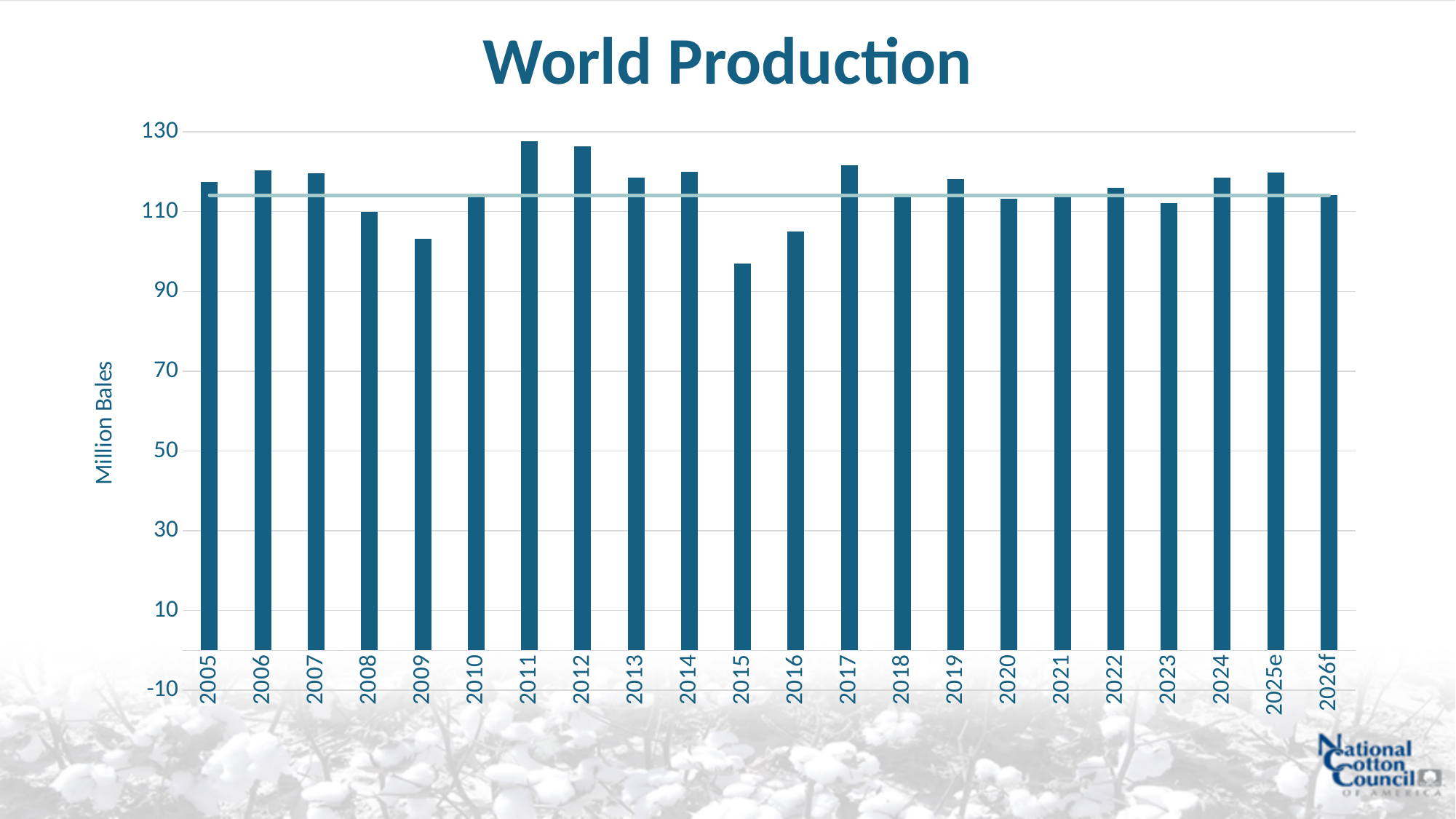
Which is larger, the value for 2011 or the value for 2015? 2011 Is the value for 2009 greater or less than 110? less Is the value for 2015 greater or less than 110? less How many years (bars) are plotted on the chart? 22 What kind of chart is shown on the slide? bar chart Is the value for 2016 greater or less than 110? less What is the title of the chart? World Production What is the label on the vertical axis of the chart? Million Bales Which year has the lowest world production on the chart? 2015 Which is larger, the value for 2009 or the value for 2017? 2017